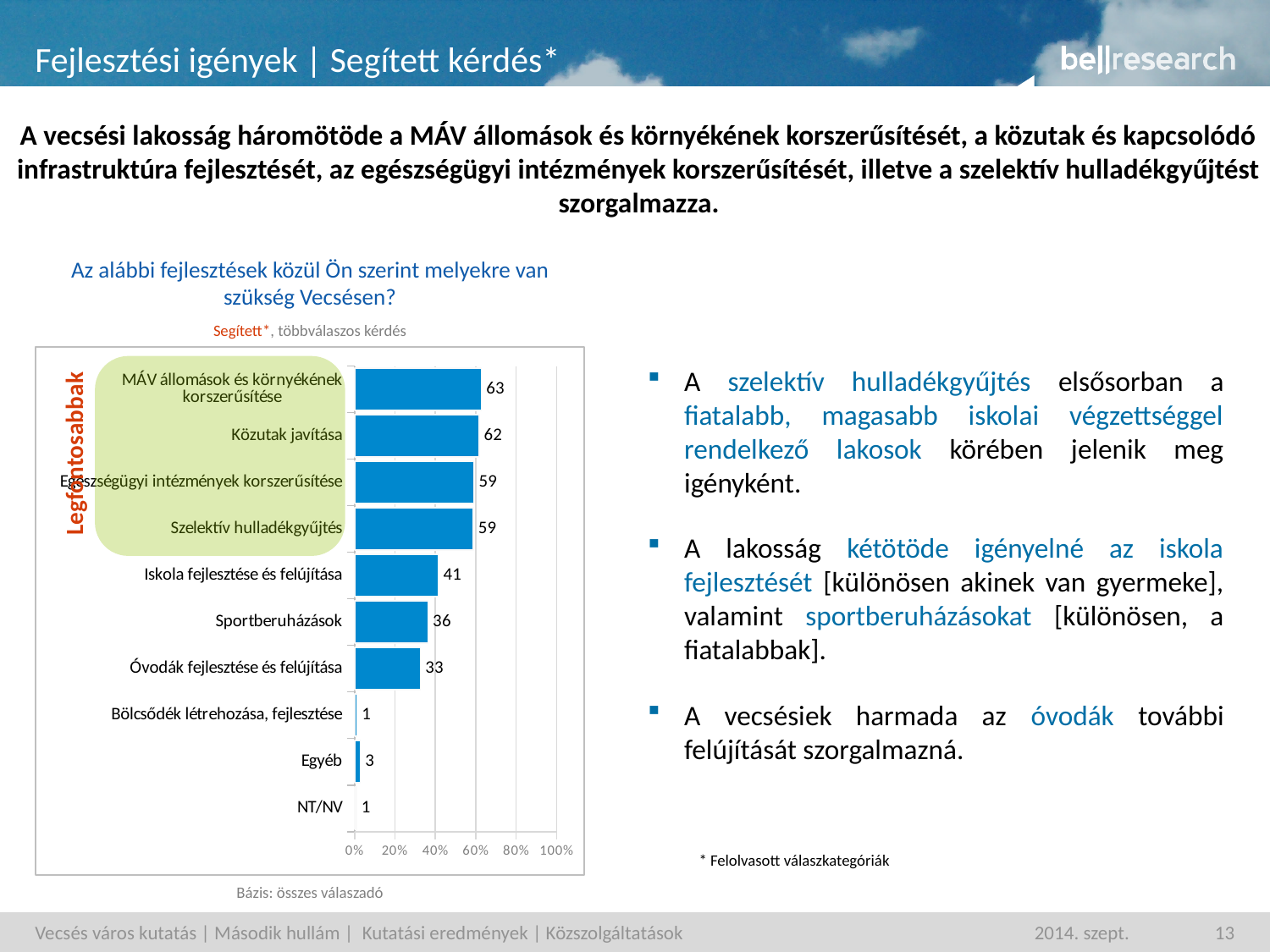
What is the question shown as the chart's title? Az alábbi fejlesztések közül Ön szerint melyekre van szükség Vecsésen? What value is shown for Közutak javítása? 62 What value is shown for Iskola fejlesztése és felújítása? 41 What value is shown for Egyéb? 3 Is the value for Egészségügyi intézmények korszerűsítése greater or less than 40%? greater What type of chart is shown on the slide? bar chart How many categories are shown in the chart? 10 Which is larger, the value for Sportberuházások or the value for Óvodák fejlesztése és felújítása? Sportberuházások What value is shown for Óvodák fejlesztése és felújítása? 33 What is the difference between the values for MÁV állomások és környékének korszerűsítése and Óvodák fejlesztése és felújítása? 30 Which category has the highest value in the chart? MÁV állomások és környékének korszerűsítése What is the difference between the values for Szelektív hulladékgyűjtés and Sportberuházások? 23